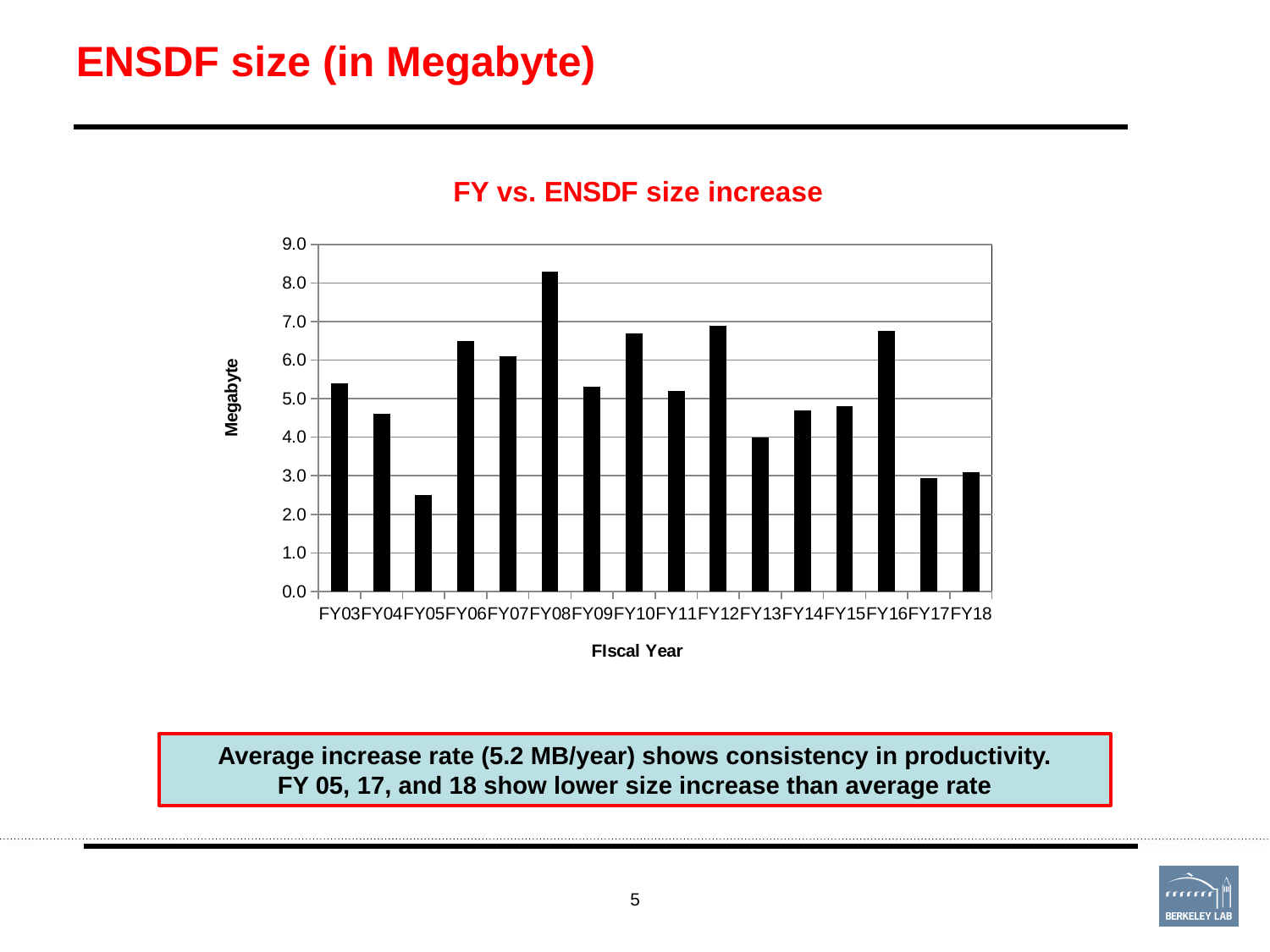
What is the title of the chart? FY vs. ENSDF size increase Which fiscal year has the highest ENSDF size increase? FY08 What is the label on the y axis of the chart? Megabyte How many fiscal years are plotted on the x axis? 16 Which has a larger value, FY08 or FY05? FY08 Is the value for FY08 greater or less than 8.0? greater Is the value for FY04 greater or less than 5.0? less What type of chart is shown on the slide? bar chart Is the value for FY05 greater or less than 3.0? less Which has a larger value, FY12 or FY13? FY12 Which fiscal year has the lowest ENSDF size increase? FY05